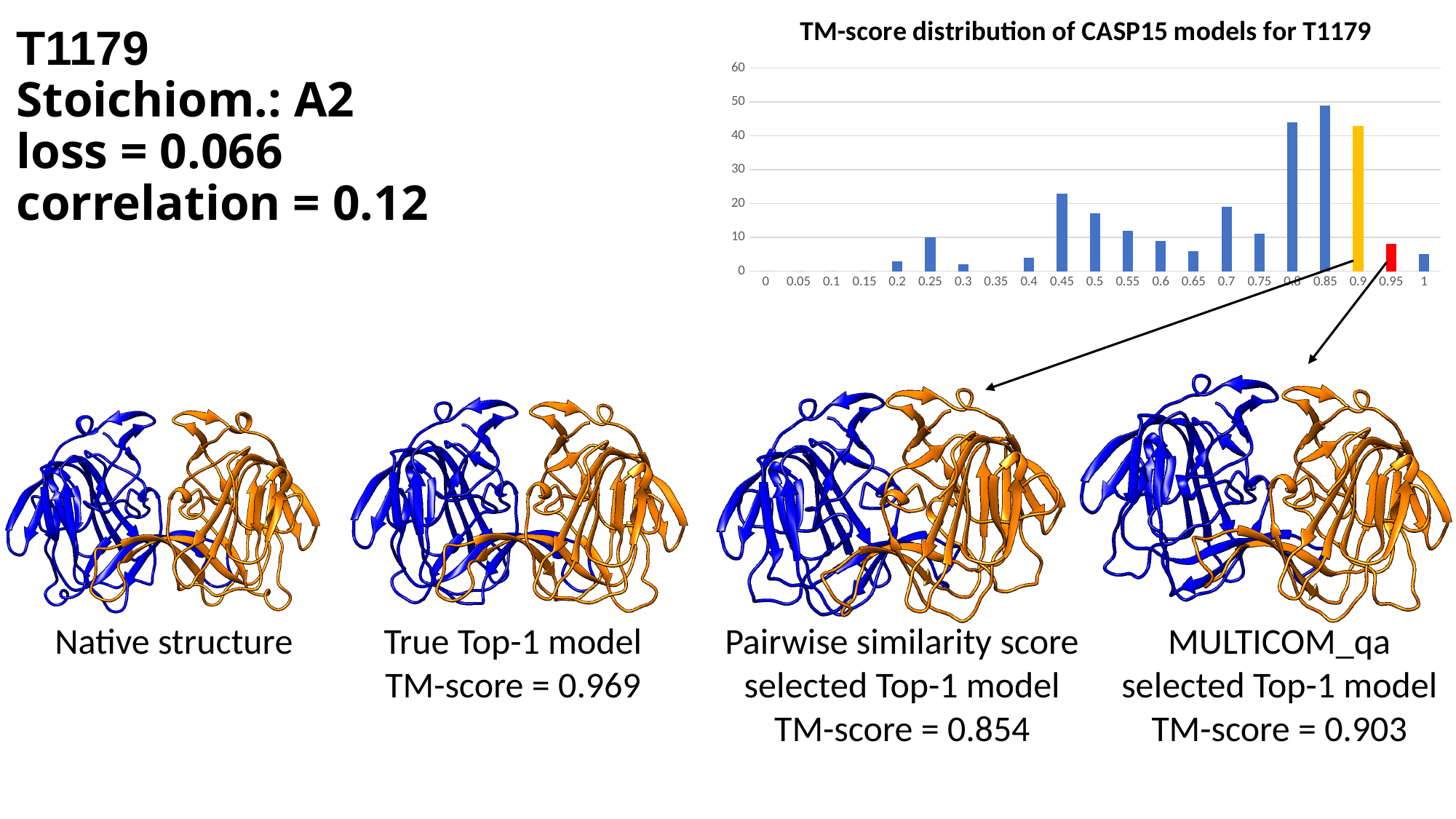
How many TM-score bins are labelled on the x axis of the chart? 21 Is the value for the 0.8 bin greater or less than 40? greater What kind of chart is shown on the slide? bar chart Is the value for the 0.95 bin greater or less than 10? less What is the title of the chart? TM-score distribution of CASP15 models for T1179 Is the value for the 0.45 bin greater or less than 30? less What colour is the bar for the 0.95 bin? red Which bin has a larger value, 0.45 or 0.5? 0.45 Which TM-score bin has the tallest bar in the chart? 0.85 Which bin has a larger value, 0.8 or 0.95? 0.8